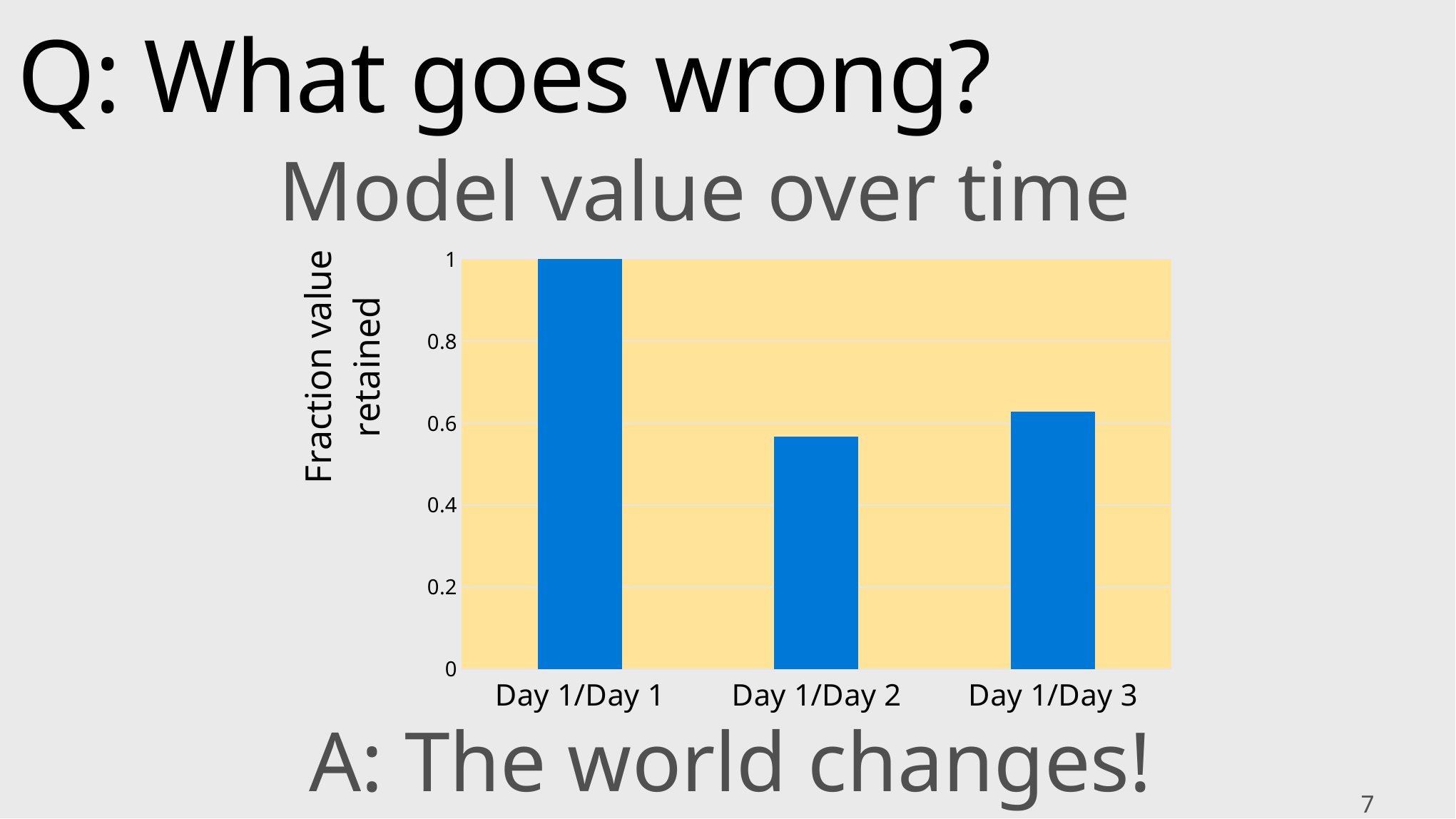
Is the value for Day 1/Day 3 greater or less than 0.6? greater What is the title of the chart? Model value over time Is the value for Day 1/Day 1 greater or less than 0.8? greater Which is larger, the value for Day 1/Day 2 or the value for Day 1/Day 3? Day 1/Day 3 Is the value for Day 1/Day 2 greater or less than 0.6? less Which is larger, the value for Day 1/Day 1 or the value for Day 1/Day 2? Day 1/Day 1 What kind of chart is shown on the slide? Bar chart What is the fraction value retained for Day 1/Day 1? 1 How many categories are shown on the x axis of the chart? 3 What is the label on the vertical axis of the chart? Fraction value retained Which category has the highest fraction value retained? Day 1/Day 1 Which category has the lowest fraction value retained? Day 1/Day 2